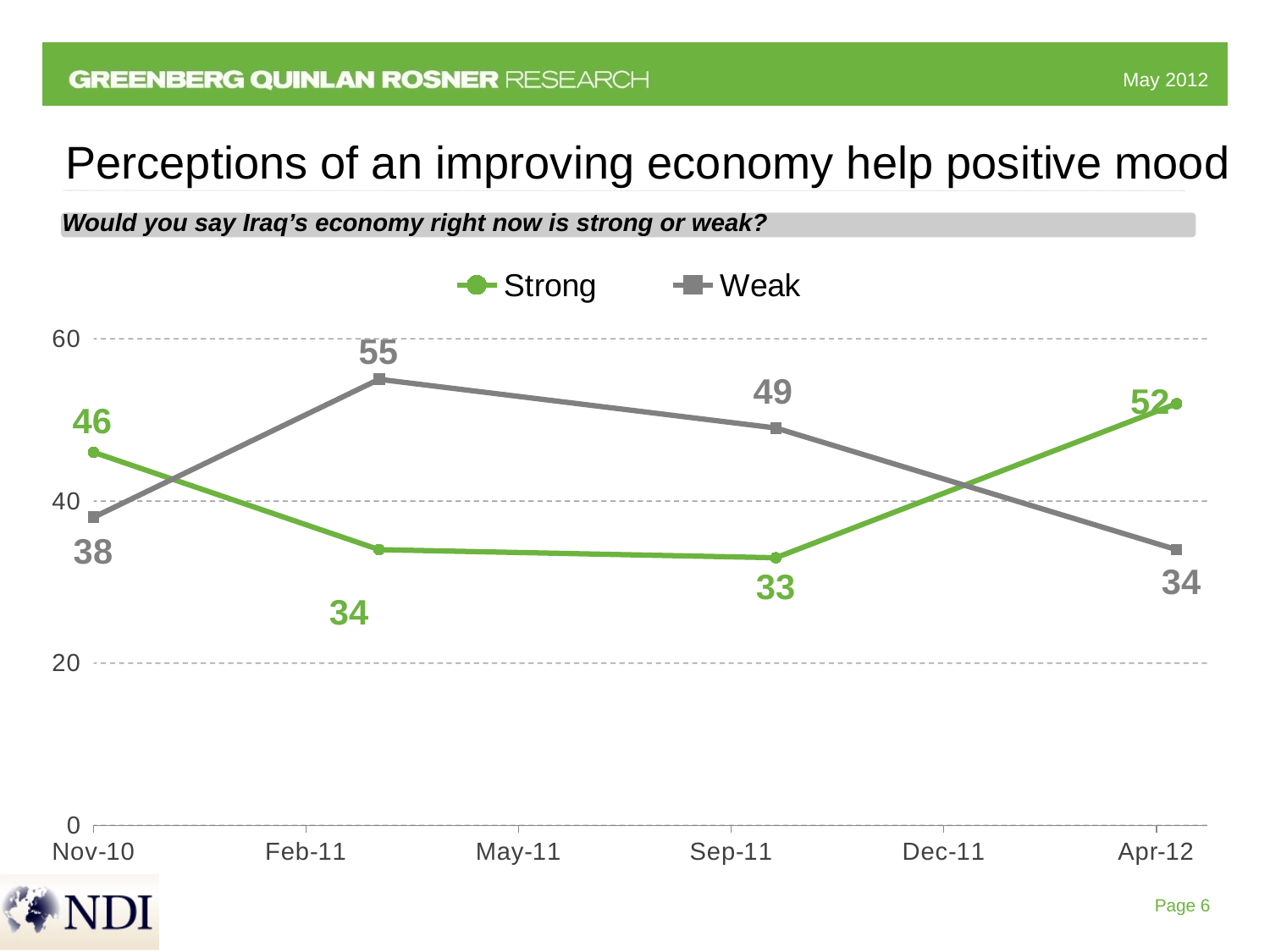
By how much did the Strong value increase from Nov-10 to Apr-12? 6 How many data points are plotted for each series? 4 How many series does the legend list? 2 What is the value for Weak at Nov-10? 38 What is the value for Weak at Apr-12? 34 What is the highest value plotted for the Weak series? 55 At the second data point (just after Feb-11), what is the difference between the Weak value and the Strong value? 21 What is the value for Strong at Nov-10? 46 What is the value for Strong at Apr-12? 52 At Apr-12, which series has the larger value, Strong or Weak? Strong What kind of chart is shown on the slide? Line chart What is the lowest value plotted for the Strong series? 33